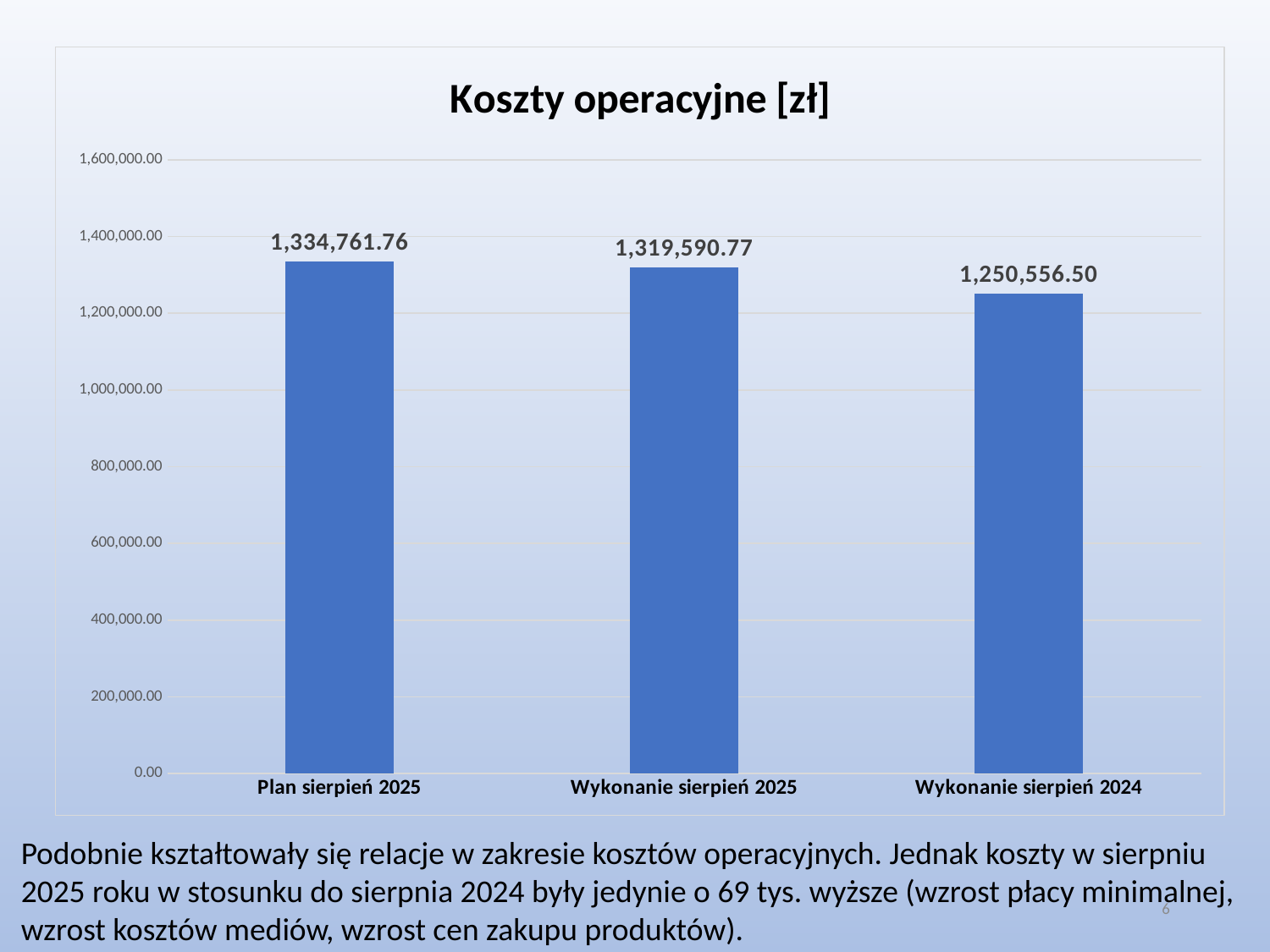
Which category has the highest value? Plan sierpień 2025 What is the title of the chart? Koszty operacyjne [zł] Which category has the lowest value? Wykonanie sierpień 2024 What is the difference between Wykonanie sierpień 2025 and Wykonanie sierpień 2024? 69,034.27 What kind of chart is shown on the slide? bar chart Which is larger, Plan sierpień 2025 or Wykonanie sierpień 2025? Plan sierpień 2025 What is the value for Wykonanie sierpień 2024? 1,250,556.50 What is the difference between Plan sierpień 2025 and Wykonanie sierpień 2025? 15,170.99 What is the value for Plan sierpień 2025? 1,334,761.76 What is the value for Wykonanie sierpień 2025? 1,319,590.77 Is the value for Wykonanie sierpień 2024 greater or less than 1,200,000.00? greater How many categories are shown on the chart? 3